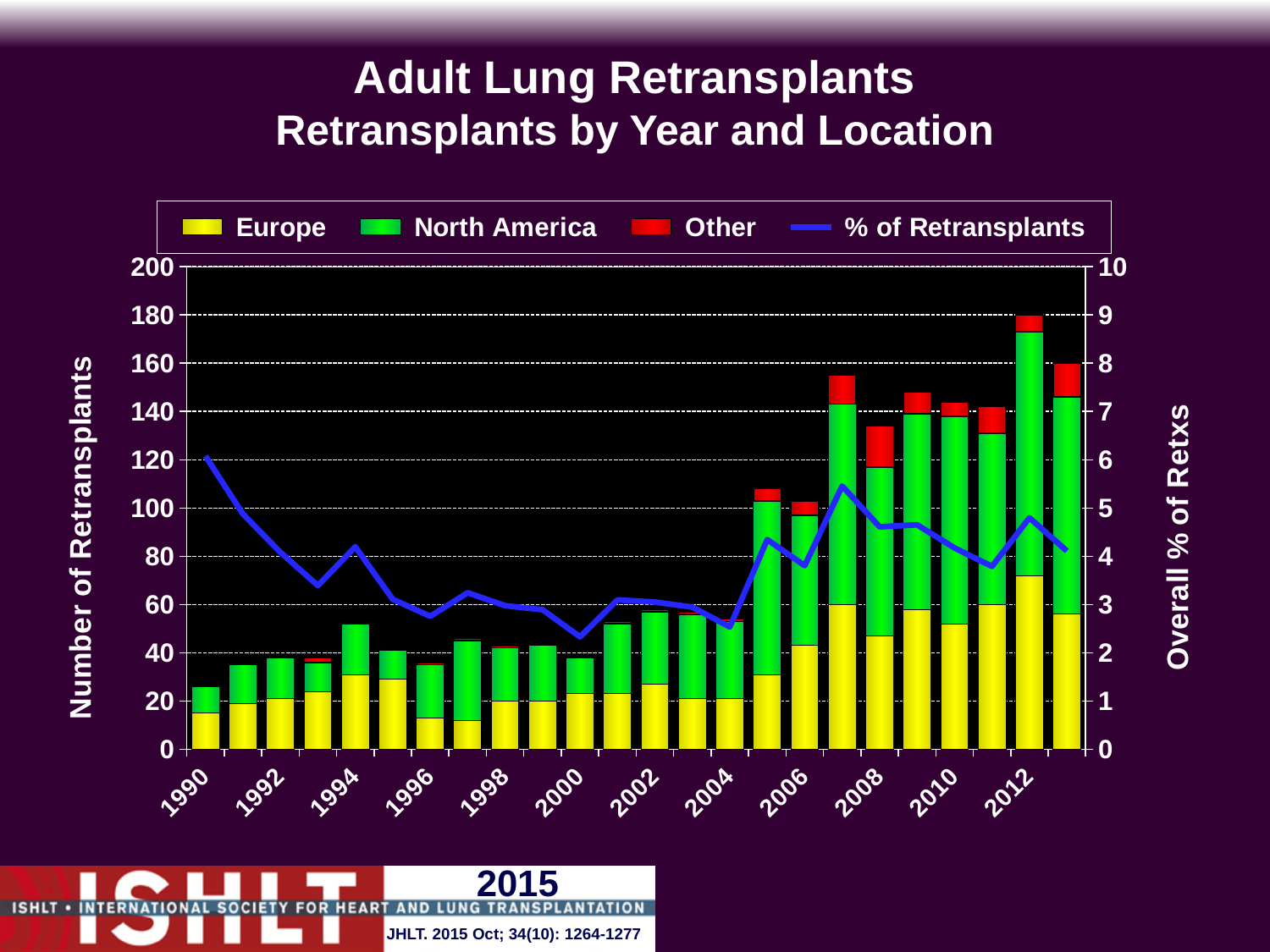
Is the total number of retransplants in 2007 greater or less than 140? greater What kind of chart is shown on the slide? combination bar and line chart Which year has the shortest stacked bar for number of retransplants? 1990 Is the total number of retransplants in 2012 greater or less than 160? greater Which year has the tallest stacked bar for number of retransplants? 2012 What colour represents Europe in the legend? yellow Is the % of Retransplants value in 1990 greater or less than 5? greater How many series does the legend list? 4 What is the title of the left vertical axis? Number of Retransplants Does the % of Retransplants line rise or fall from 1990 to 1993? fall Which year has the larger total number of retransplants, 2007 or 2008? 2007